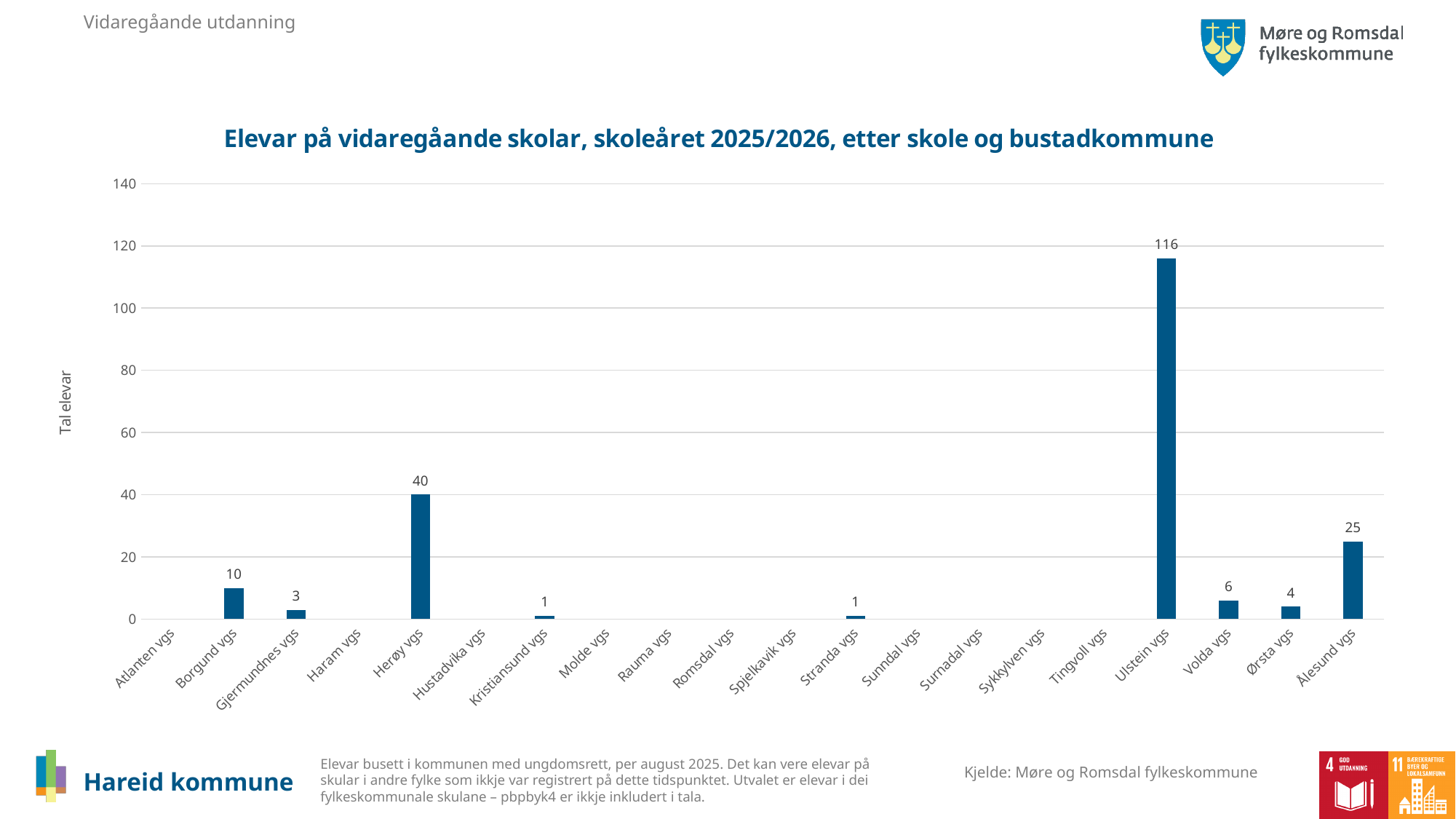
What is the value for Ulstein vgs? 116 Which school has the highest number of students? Ulstein vgs What is the value for Borgund vgs? 10 What is the difference between the values for Ulstein vgs and Herøy vgs? 76 What kind of chart is shown on the slide? Bar chart What is the label of the y axis? Tal elevar How many schools are listed on the x axis? 20 What is the value for Ålesund vgs? 25 Is the value for Ulstein vgs greater or less than 100? greater What is the difference between the values for Ålesund vgs and Borgund vgs? 15 What is the value for Herøy vgs? 40 Which is larger, the value for Volda vgs or the value for Ørsta vgs? Volda vgs